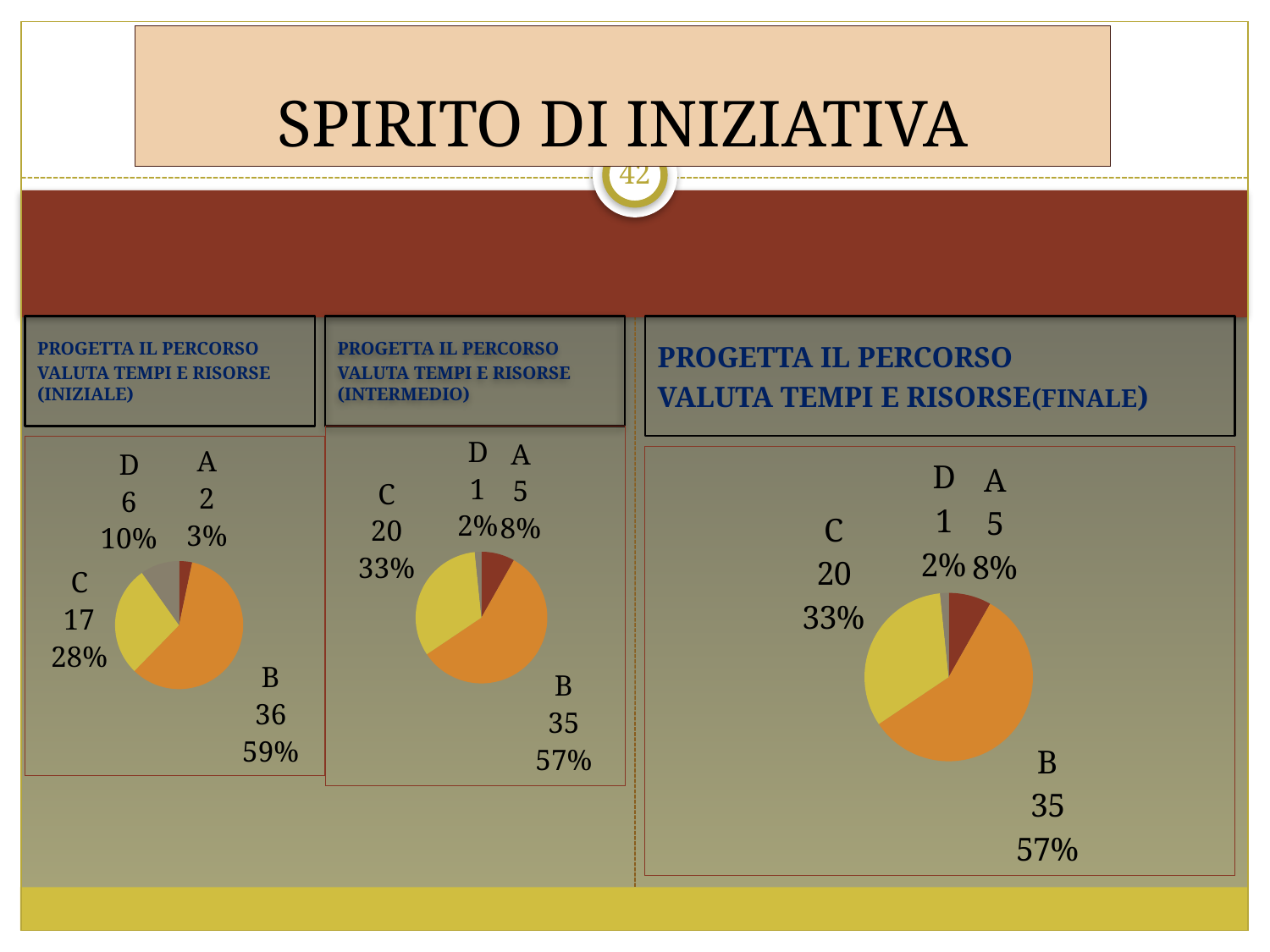
How many categories does the FINALE pie chart show? 4 In the INTERMEDIO pie chart, what percentage share does category D have? 2% In the FINALE pie chart, what is the difference between the values for B and C? 15 In the INTERMEDIO pie chart, what is the value for category C? 20 In the INIZIALE pie chart, what is the value for category B? 36 In the INIZIALE pie chart, what is the difference between the values for B and C? 19 In the INIZIALE pie chart, which category has the smallest value? A In the FINALE pie chart, what is the value for category A? 5 In the INIZIALE pie chart, what percentage share does category C have? 28% In the INTERMEDIO pie chart, which category has the largest value? B What kind of chart is used in the INIZIALE panel? Pie chart In the FINALE pie chart, which is larger, the value for C or the value for A? C